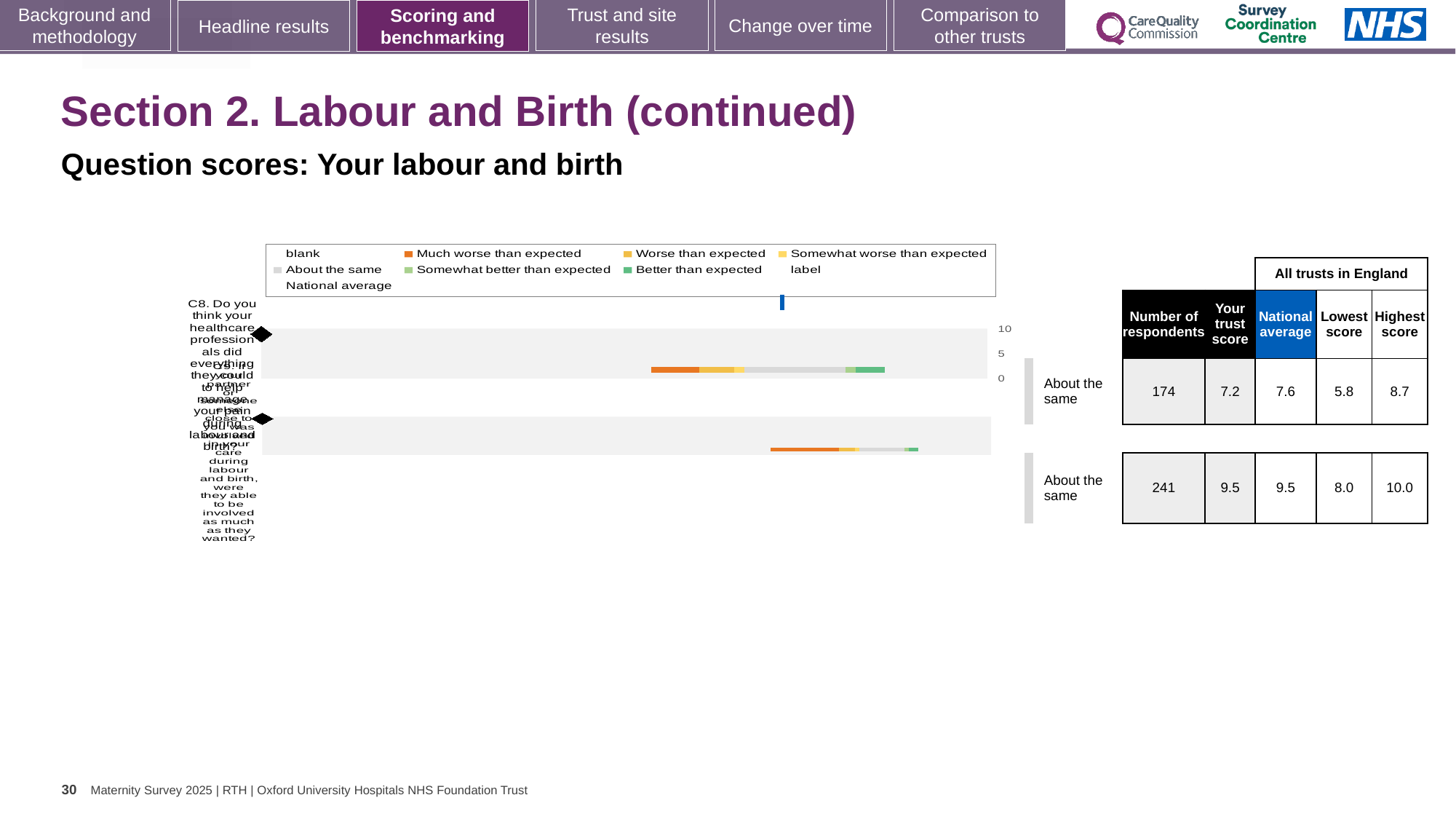
What is the highest score across all trusts in England for the second row? 10.0 Which row has more respondents, the first row or the second row? the second row What is the difference between the national average and the trust score for question C8? 0.4 What is the trust score for question C8 (the first row)? 7.2 How many questions (rows) are plotted on the chart? 2 How many respondents are shown for question C8 (the first row)? 174 Is the trust score for question C8 higher or lower than the national average? lower What colour represents 'Much worse than expected' in the legend? orange What is the national average for question C8 (the first row)? 7.6 What benchmark category is shown for question C8 (the first row)? About the same What kind of chart is shown on the slide? bar chart What is the lowest score across all trusts in England for the second row? 8.0